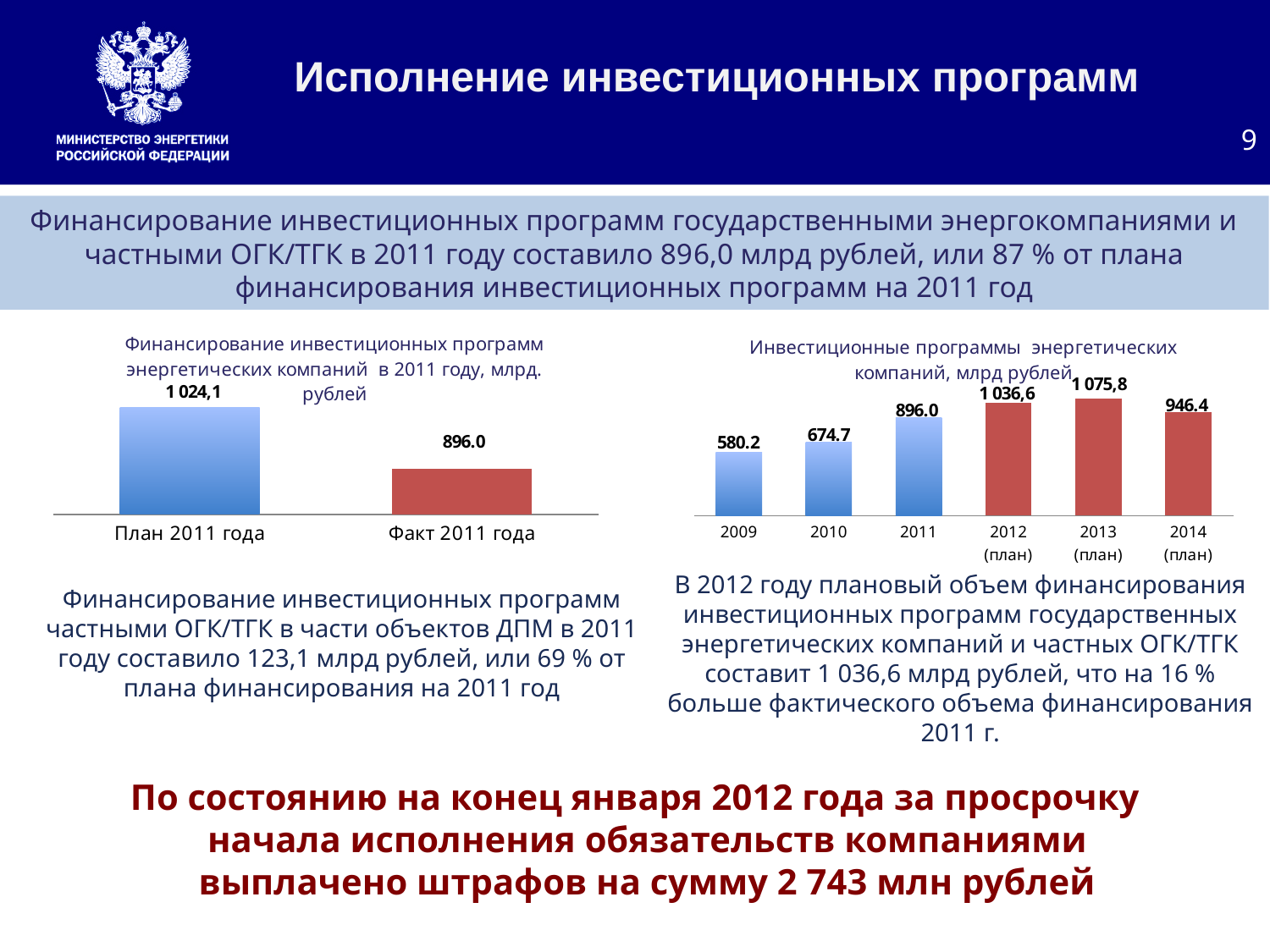
In the right chart, what is the value for 2010? 674.7 In the right chart, what is the value for 2013 (план)? 1 075,8 What kind of chart is the left chart? bar chart In the left chart, what is the difference between План 2011 года and Факт 2011 года? 128.1 In the right chart, which year has the highest value? 2013 (план) In the left chart, what is the value for Факт 2011 года? 896.0 In the right chart, which is larger: the value for 2012 (план) or the value for 2014 (план)? 2012 (план) In the right chart, do the values rise or fall from 2009 to 2011? rise In the right chart, what is the difference between the values for 2010 and 2009? 94.5 In the left chart, what is the value for План 2011 года? 1 024,1 In the right chart, which year has the lowest value? 2009 In the right chart, how many years are shown? 6